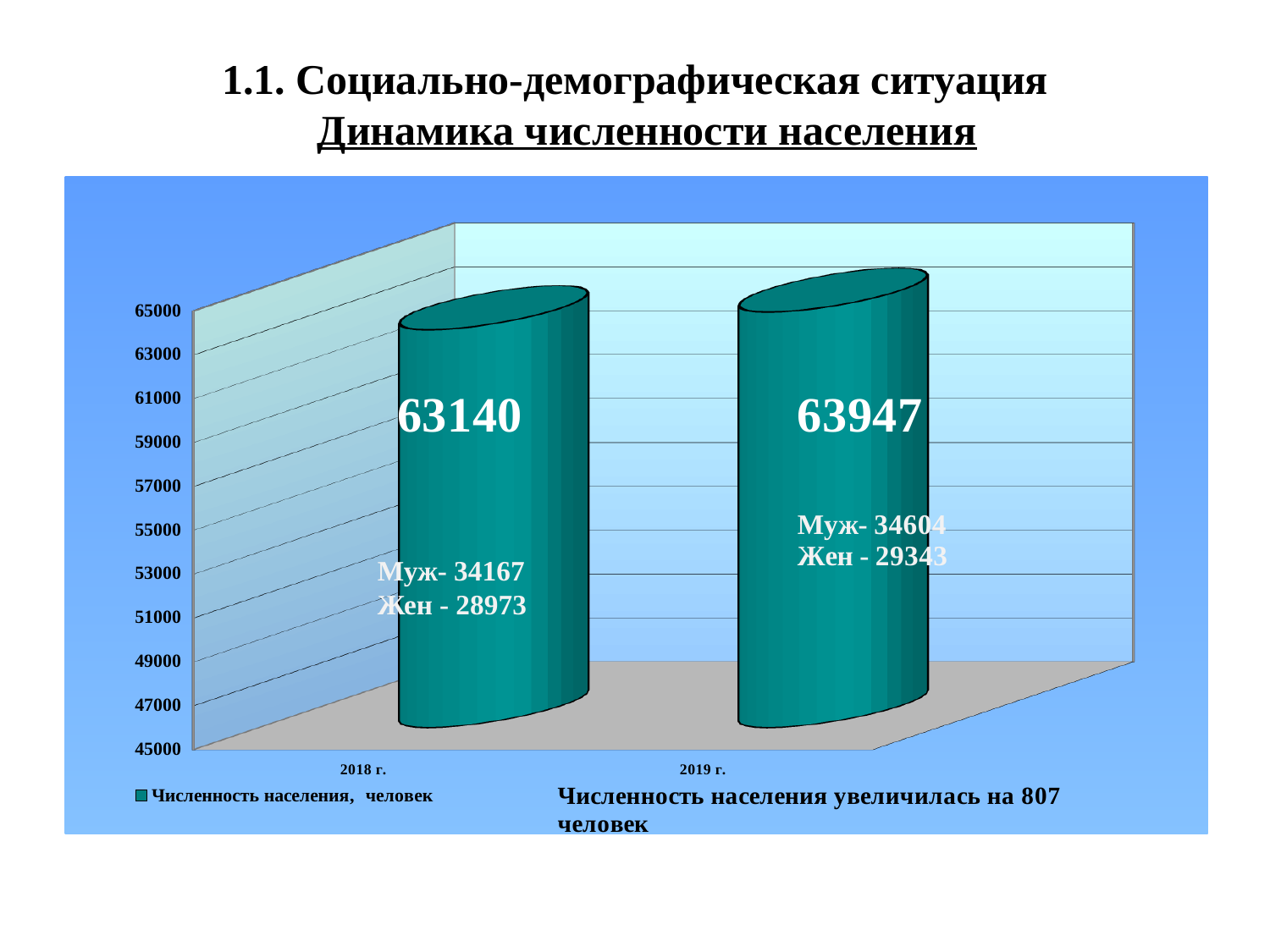
What is the legend entry for the series shown in the chart? Численность населения, человек How many series does the legend list? 1 Do the population values rise or fall from 2018 г. to 2019 г.? rise Which year has the higher population value? 2019 г. Is the population value for 2019 г. larger or smaller than the value for 2018 г.? larger How many years (categories) are shown on the x axis? 2 Is the population value for 2018 г. greater or less than 61000? greater By how much did the population value increase from 2018 г. to 2019 г.? 807 Which year has the lower population value? 2018 г. What is the population value shown for 2019 г.? 63947 What kind of chart is shown on the slide? bar chart What is the population value shown for 2018 г.? 63140